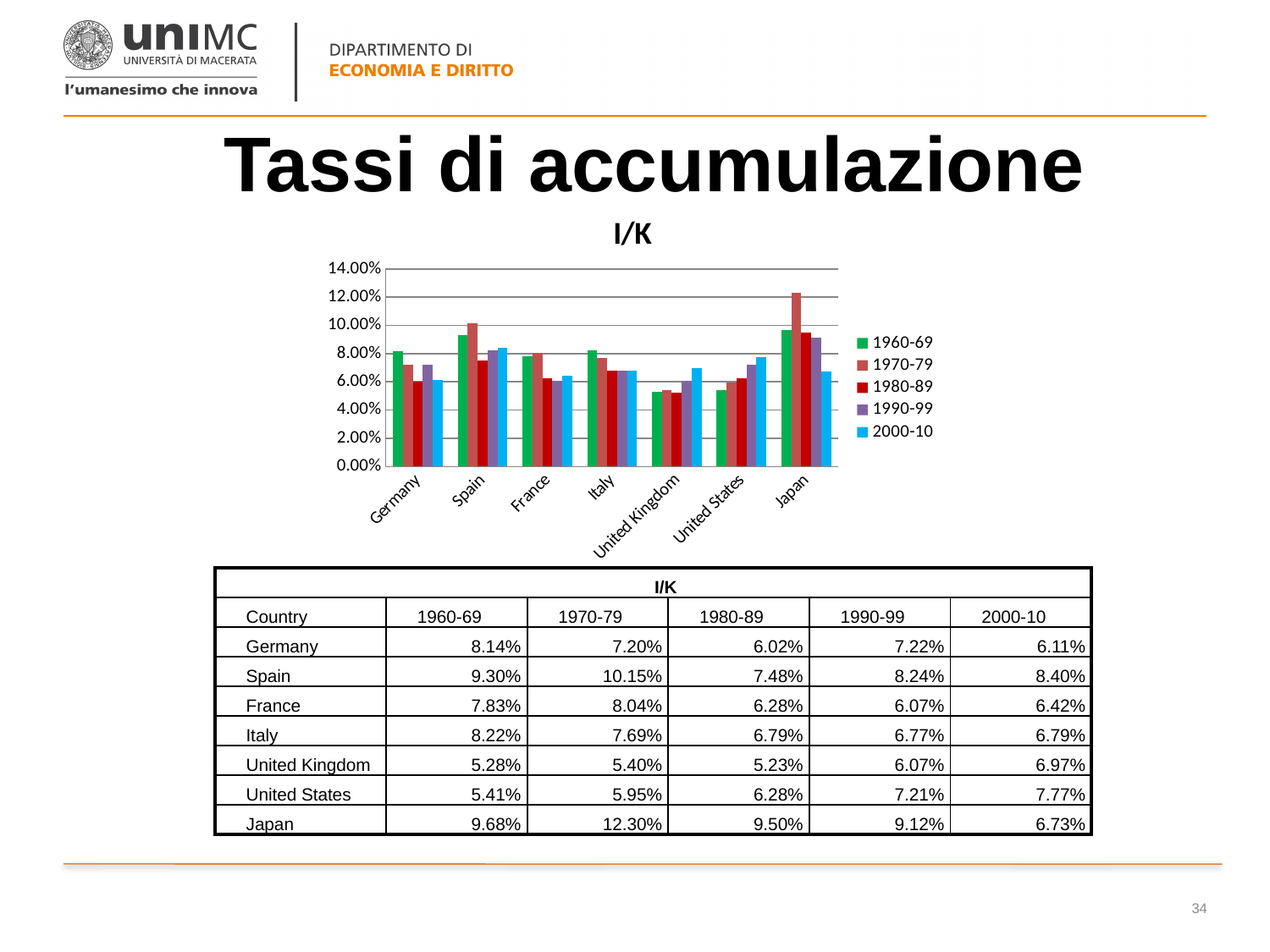
Is the I/K value for Japan in 1970-79 greater or less than 12.00%? greater Which country has the highest I/K value in the 1970-79 series? Japan What is the I/K value for Japan in 1970-79? 12.30% How many countries are shown on the x axis of the chart? 7 What is the difference between Japan's and Germany's I/K values in 1970-79? 5.10% Which country has the lowest I/K value in the 1960-69 series? United Kingdom What is the I/K value for the United Kingdom in 2000-10? 6.97% What is the title of the chart? I/K What is the I/K value for Spain in 1960-69? 9.30% What type of chart is shown on the slide? bar chart How many series does the chart legend list? 5 Which is larger, Spain's I/K value in 2000-10 or France's I/K value in 2000-10? Spain